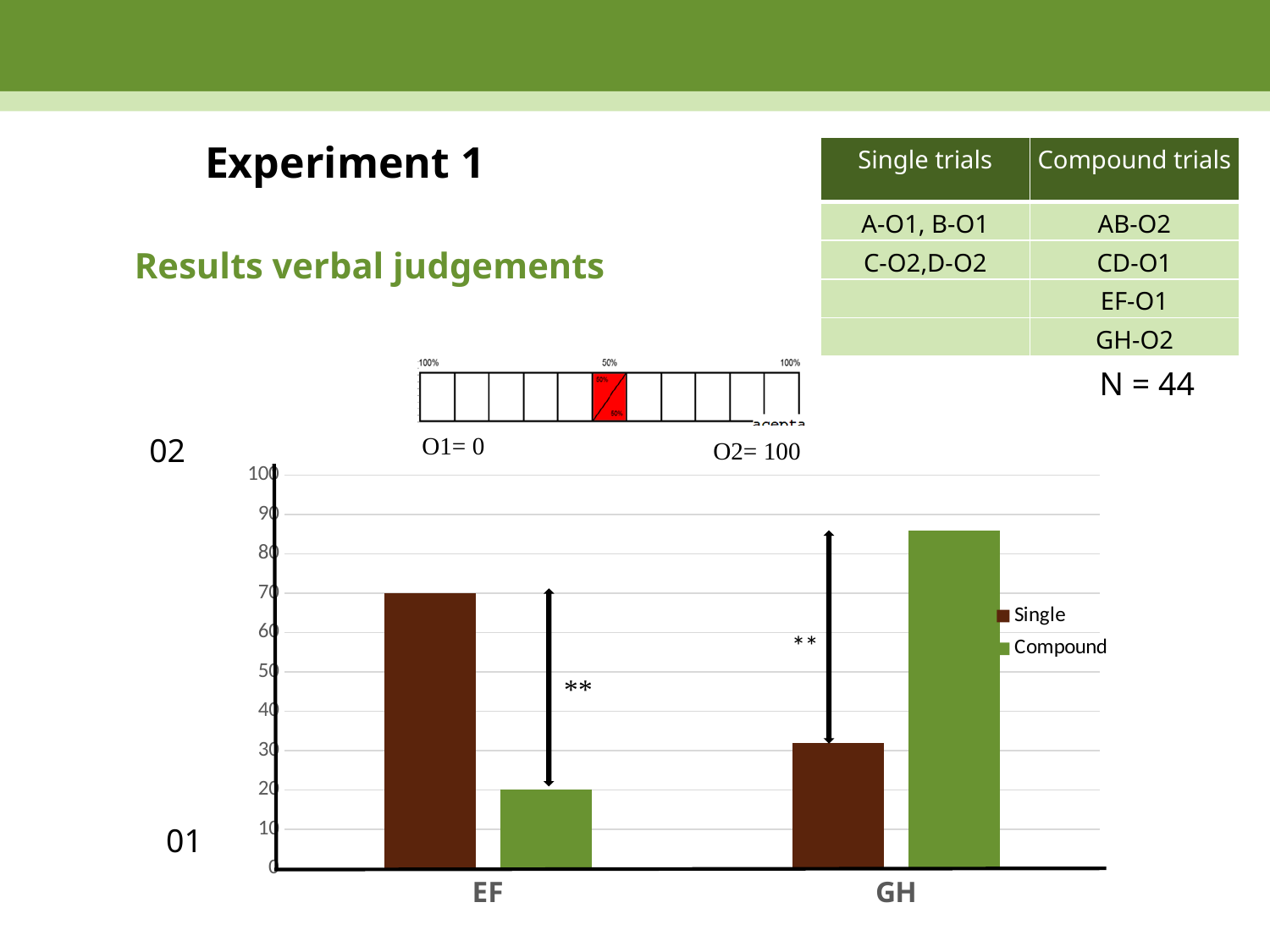
How many categories are shown on the x axis of the chart? 2 Is the value of the Compound bar for GH greater or less than 80? greater What is the value of the Single bar for EF? 70 Which bar in the chart is the lowest? Compound for EF What is the difference between the Single and Compound values for EF? 50 What is the value of the Compound bar for EF? 20 What kind of chart is shown on the slide? bar chart How many series does the chart legend list? 2 For EF, which is larger, the Single bar or the Compound bar? Single For GH, which is larger, the Single bar or the Compound bar? Compound Is the value of the Single bar for GH greater or less than 40? less Which bar in the chart is the highest? Compound for GH